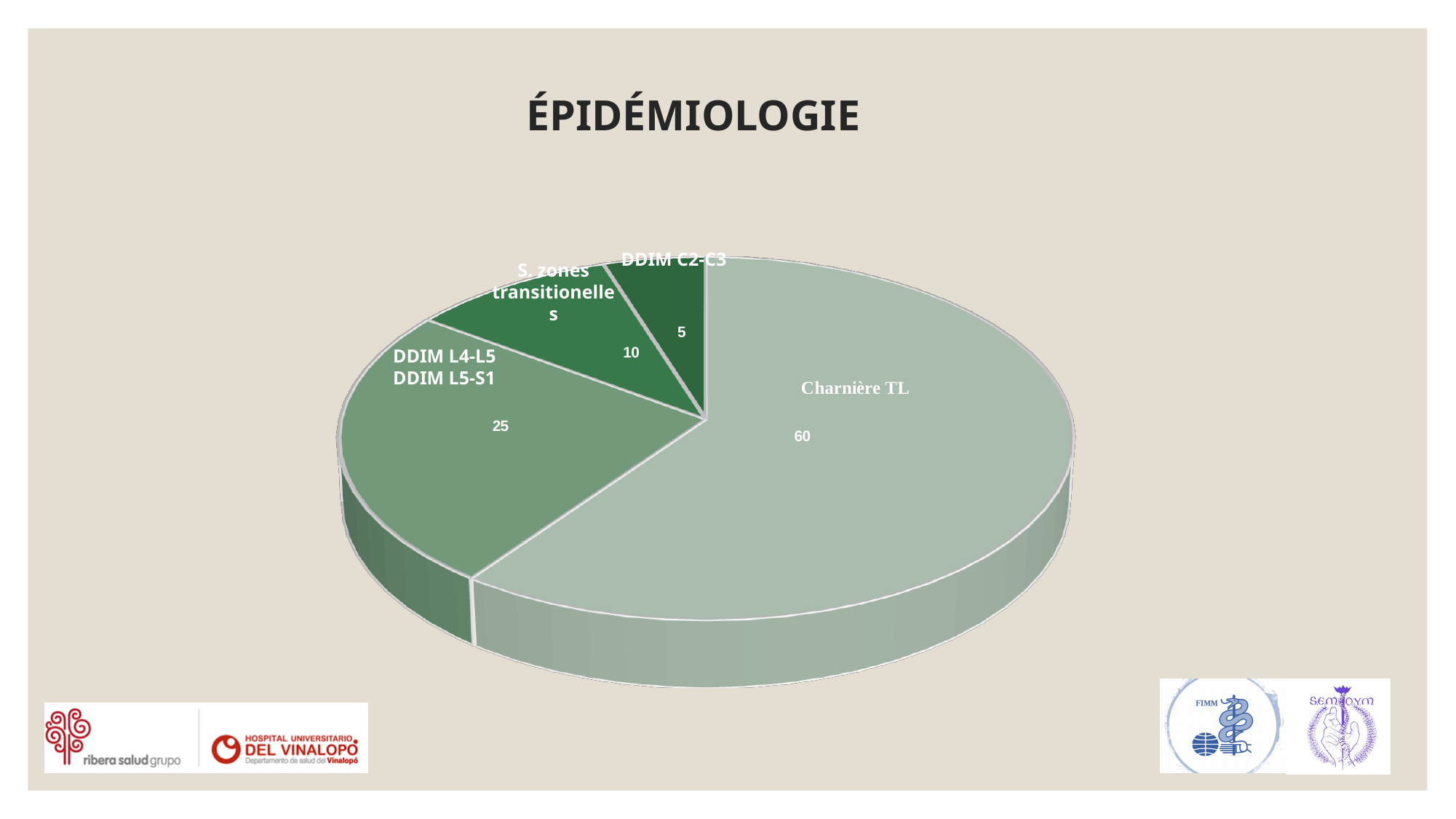
What is the difference between the values for Charnière TL and DDIM L4-L5 / DDIM L5-S1? 35 What is the value for DDIM L4-L5 / DDIM L5-S1? 25 Which is larger, the value for S. zones transitionelles or the value for DDIM C2-C3? S. zones transitionelles How many slices does the pie chart have? 4 What is the title of the slide containing the pie chart? ÉPIDÉMIOLOGIE What is the value for S. zones transitionelles? 10 What is the value for DDIM C2-C3? 5 What share of the pie does Charnière TL represent? 60% What is the value for Charnière TL? 60 Which slice of the pie is the smallest? DDIM C2-C3 Which slice of the pie is the largest? Charnière TL What kind of chart is shown on the slide? pie chart